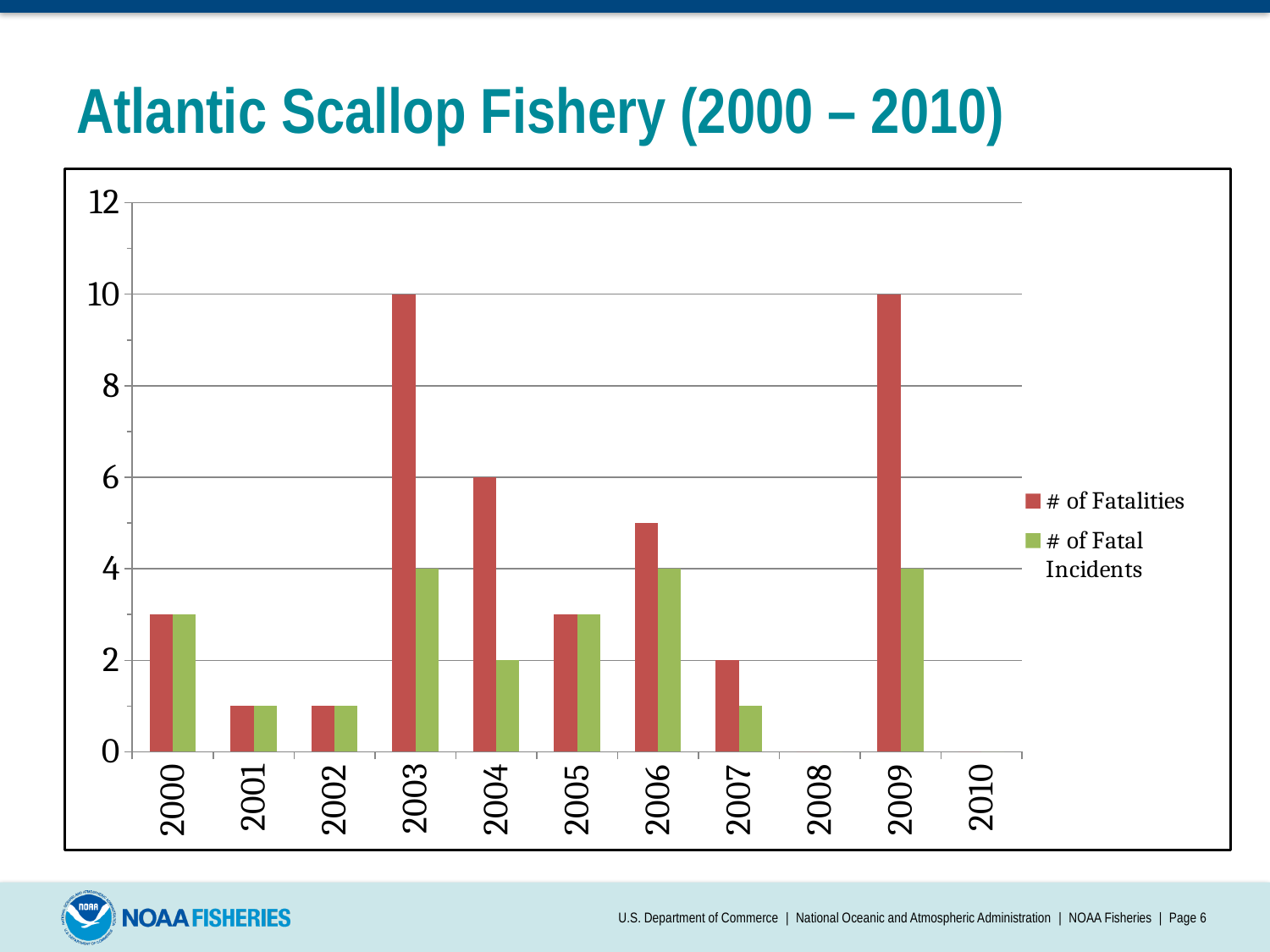
Is the number of fatalities in 2001 greater or less than 2? less What is the difference between the number of fatalities and the number of fatal incidents in 2003? 6 Which year had more fatalities, 2004 or 2005? 2004 How many series does the legend list? 2 Is the number of fatalities in 2006 greater or less than 4? greater What is the title of the slide containing the chart? Atlantic Scallop Fishery (2000 – 2010) What type of chart is shown on the slide? Bar chart How many years are shown on the x axis? 11 What is the number of fatalities in 2004? 6 What is the number of fatal incidents in 2004? 2 What is the number of fatal incidents in 2009? 4 What is the number of fatalities in 2003? 10